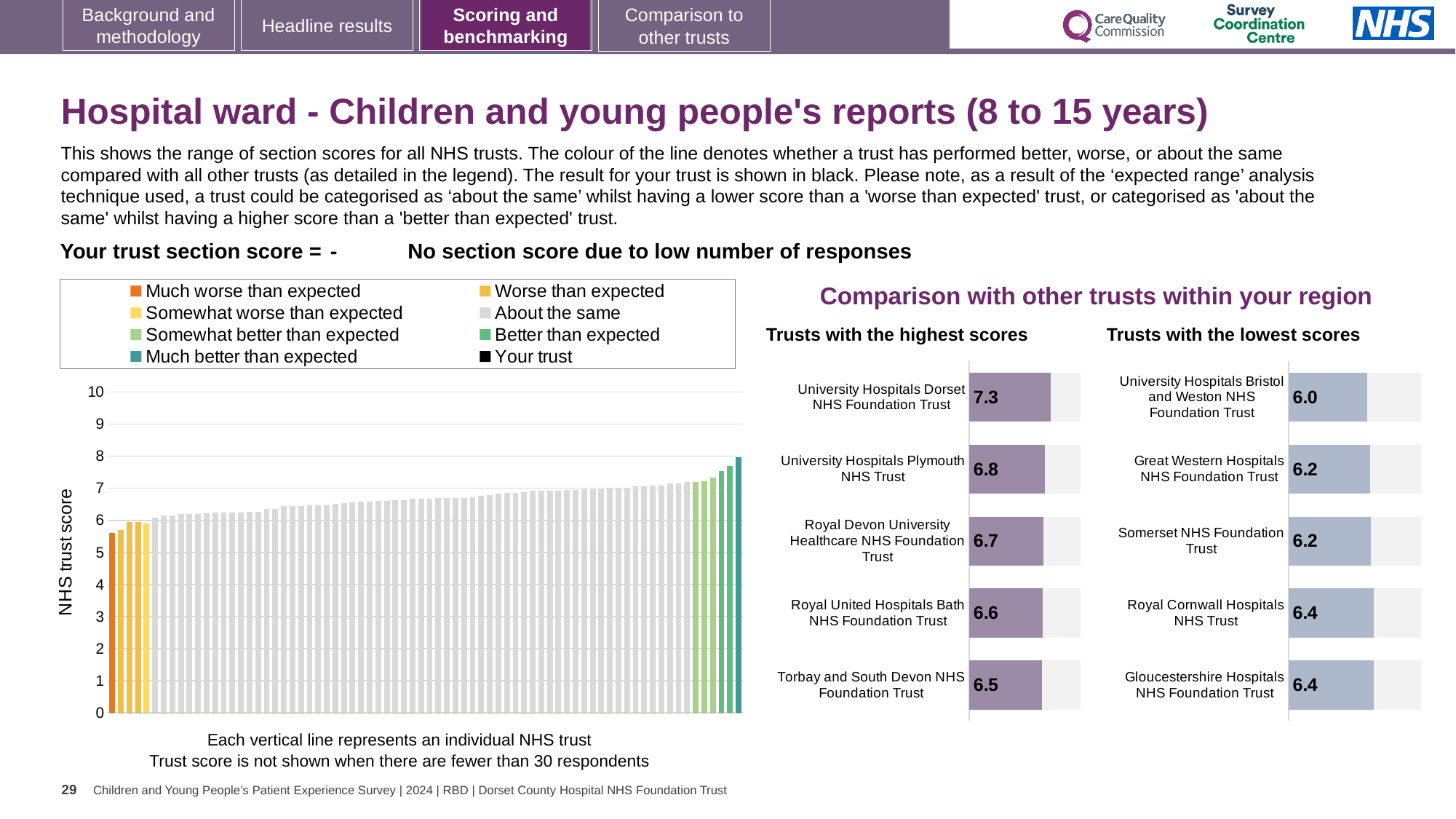
In the 'Trusts with the highest scores' chart, which trust has the highest score? University Hospitals Dorset NHS Foundation Trust In the 'Trusts with the highest scores' chart, which has the higher score: University Hospitals Plymouth NHS Trust or Royal United Hospitals Bath NHS Foundation Trust? University Hospitals Plymouth NHS Trust In the 'Trusts with the highest scores' chart, what is the score for Torbay and South Devon NHS Foundation Trust? 6.5 In the 'Trusts with the lowest scores' chart, what is the score for Royal Cornwall Hospitals NHS Trust? 6.4 How many entries does the legend of the main chart on the left list? 8 How many trusts are shown in the 'Trusts with the lowest scores' chart? 5 In the 'Trusts with the highest scores' chart, what is the score for University Hospitals Dorset NHS Foundation Trust? 7.3 In the 'Trusts with the lowest scores' chart, what is the score for University Hospitals Bristol and Weston NHS Foundation Trust? 6.0 In the main chart on the left showing all NHS trusts, do the bar values rise or fall from left to right? rise In the main chart on the left showing all NHS trusts, is the value of the tallest bar greater or less than 7? greater In the 'Trusts with the lowest scores' chart, which trust has the lowest score? University Hospitals Bristol and Weston NHS Foundation Trust In the 'Trusts with the highest scores' chart, what is the difference between the scores of University Hospitals Dorset NHS Foundation Trust and Torbay and South Devon NHS Foundation Trust? 0.8